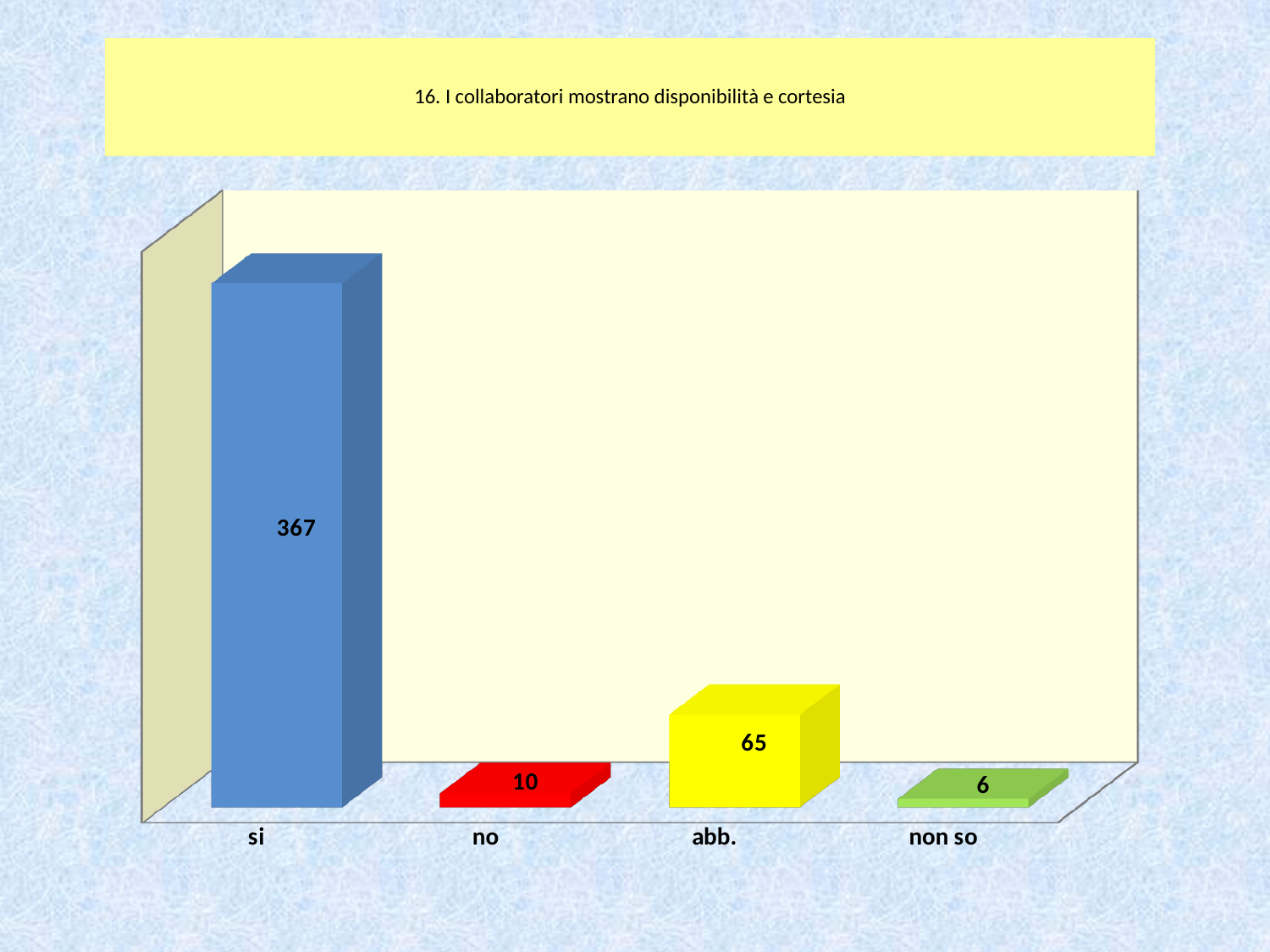
How many categories are shown on the x axis? 4 What is the value for "no"? 10 What is the title shown above the chart? 16. I collaboratori mostrano disponibilità e cortesia Which category has the highest value? si What is the difference between the values for "si" and "abb."? 302 What is the value for "non so"? 6 What is the value for "abb."? 65 What kind of chart is shown on the slide? bar chart Which category has the lowest value? non so Which is larger, the value for "abb." or the value for "no"? abb. What is the value for "si"? 367 What is the difference between the values for "no" and "non so"? 4